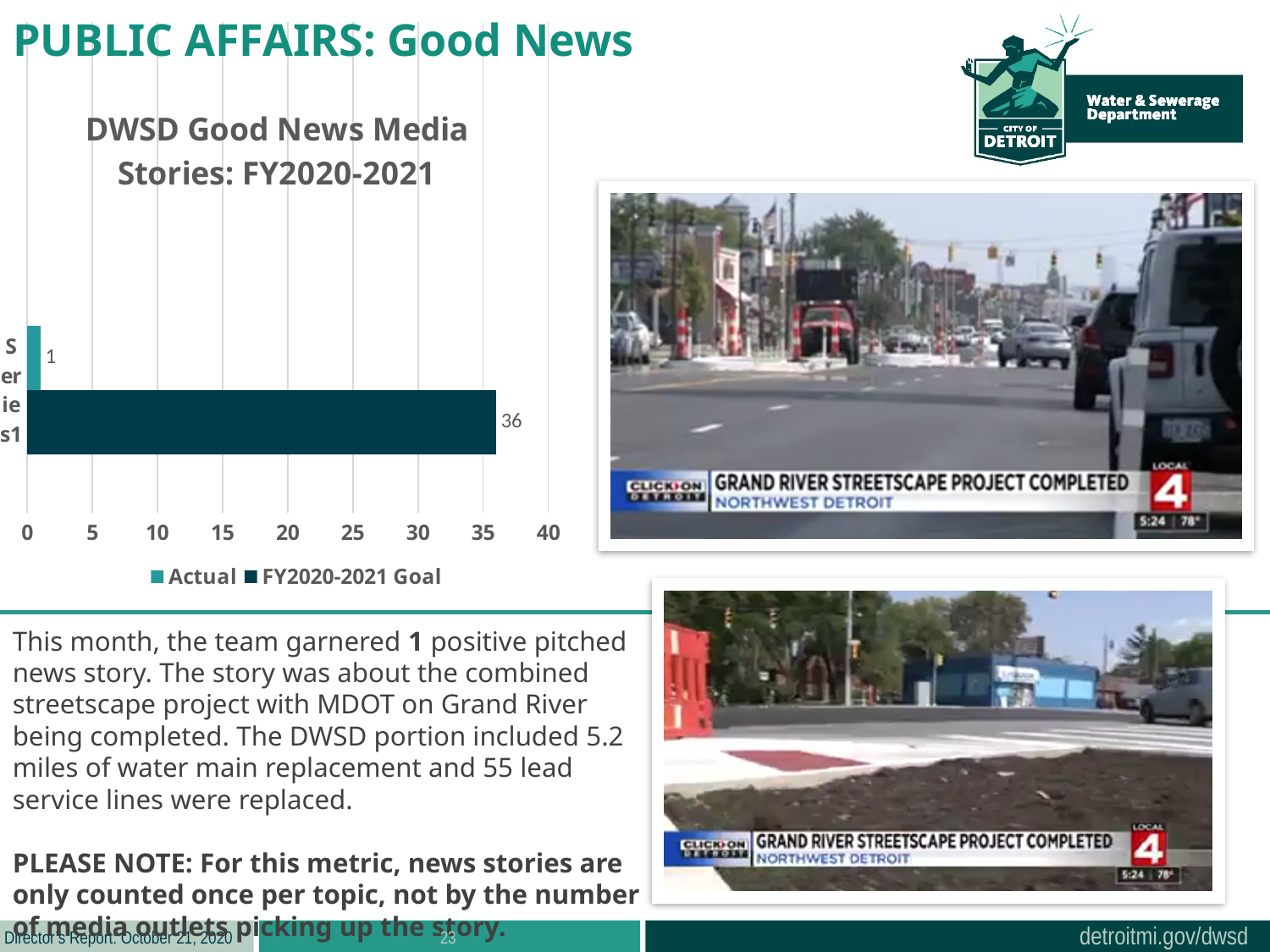
Which series has the smallest value in the chart? Actual What is the value of the FY2020-2021 Goal bar in the chart? 36 What is the title of the chart on the slide? DWSD Good News Media Stories: FY2020-2021 What type of chart is shown on the slide? bar chart Which series has the larger value in the chart, Actual or FY2020-2021 Goal? FY2020-2021 Goal Is the FY2020-2021 Goal value in the chart greater or less than 30? greater What is the maximum value shown on the chart's horizontal axis? 40 What is the value of the Actual bar in the chart? 1 Is the Actual value in the chart greater or less than 5? less How many series does the chart's legend list? 2 What are the two series named in the chart's legend? Actual and FY2020-2021 Goal What is the difference between the FY2020-2021 Goal value and the Actual value in the chart? 35